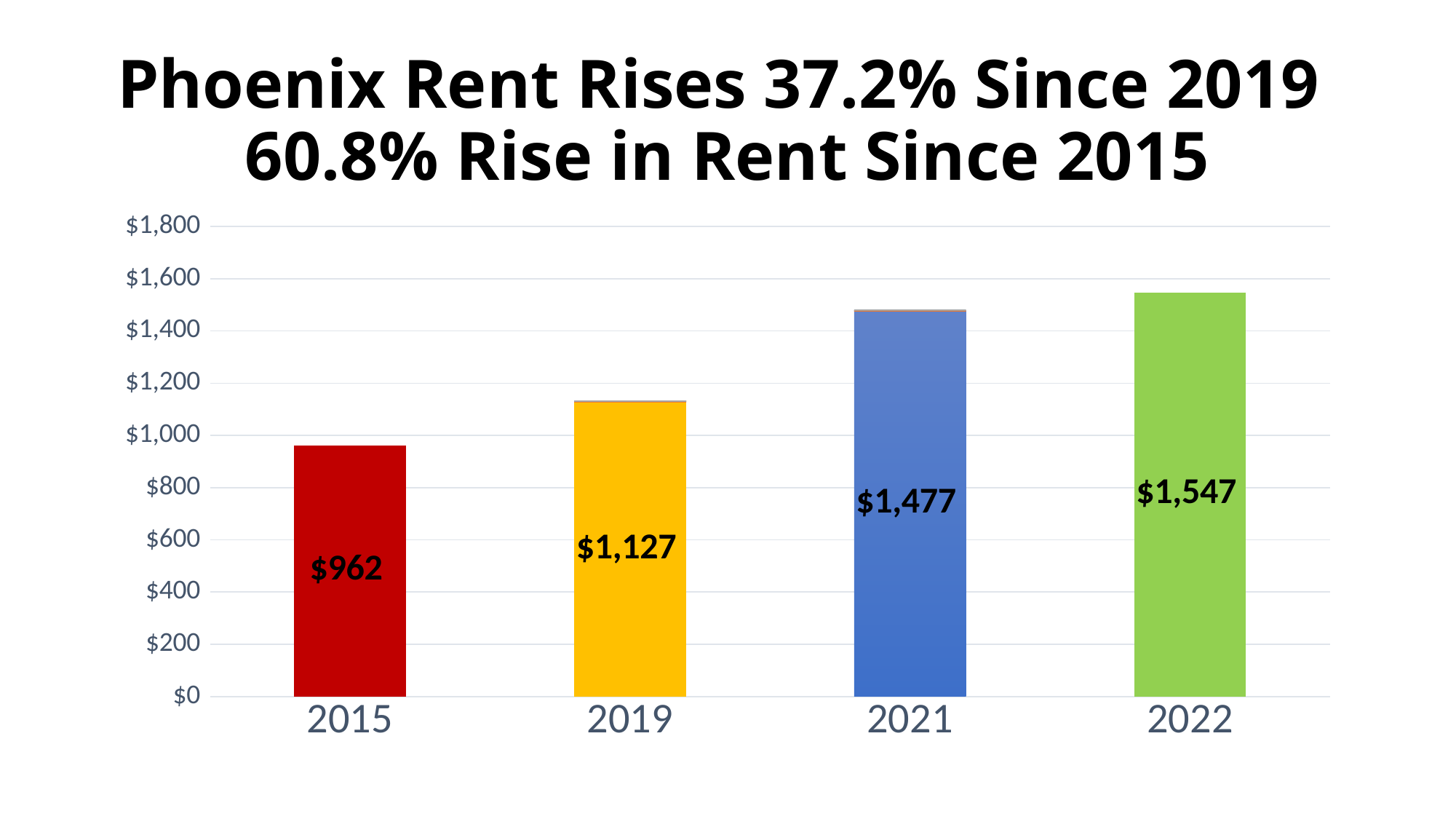
Which year has the lowest rent value? 2015 Which is larger, the rent value for 2019 or for 2021? 2021 What kind of chart is shown on the slide? Bar chart What is the rent value shown for 2015? $962 What is the rent value shown for 2019? $1,127 Do the rent values rise or fall from 2015 to 2022? Rise Which year has the highest rent value? 2022 What is the difference between the rent values for 2021 and 2019? $350 How many years are shown on the chart? 4 What is the difference between the rent values for 2022 and 2015? $585 What is the rent value shown for 2022? $1,547 What is the rent value shown for 2021? $1,477